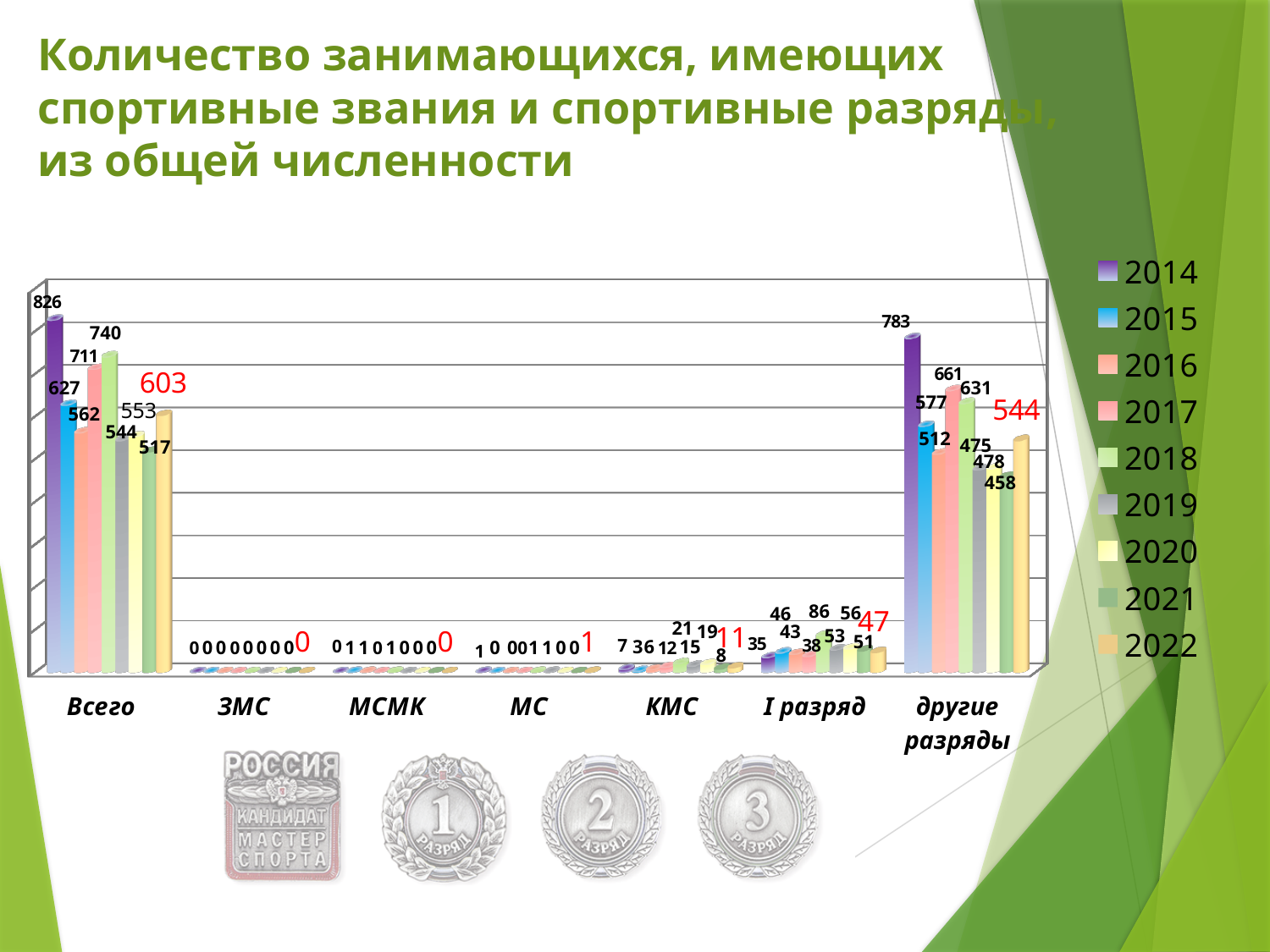
How many categories are shown on the x axis? 7 What is the value for Всего in 2014? 826 How many series does the legend list? 9 What is the value for другие разряды in 2014? 783 Which year has the highest value for Всего? 2014 Which is larger for Всего: the value for 2017 or the value for 2018? 2018 What is the value for ЗМС in 2022? 0 What is the difference between the Всего values for 2014 and 2022? 223 What is the value for Всего in 2022? 603 Which year has the lowest value for Всего? 2021 What kind of chart is shown on the slide? bar chart What is the value for другие разряды in 2022? 544